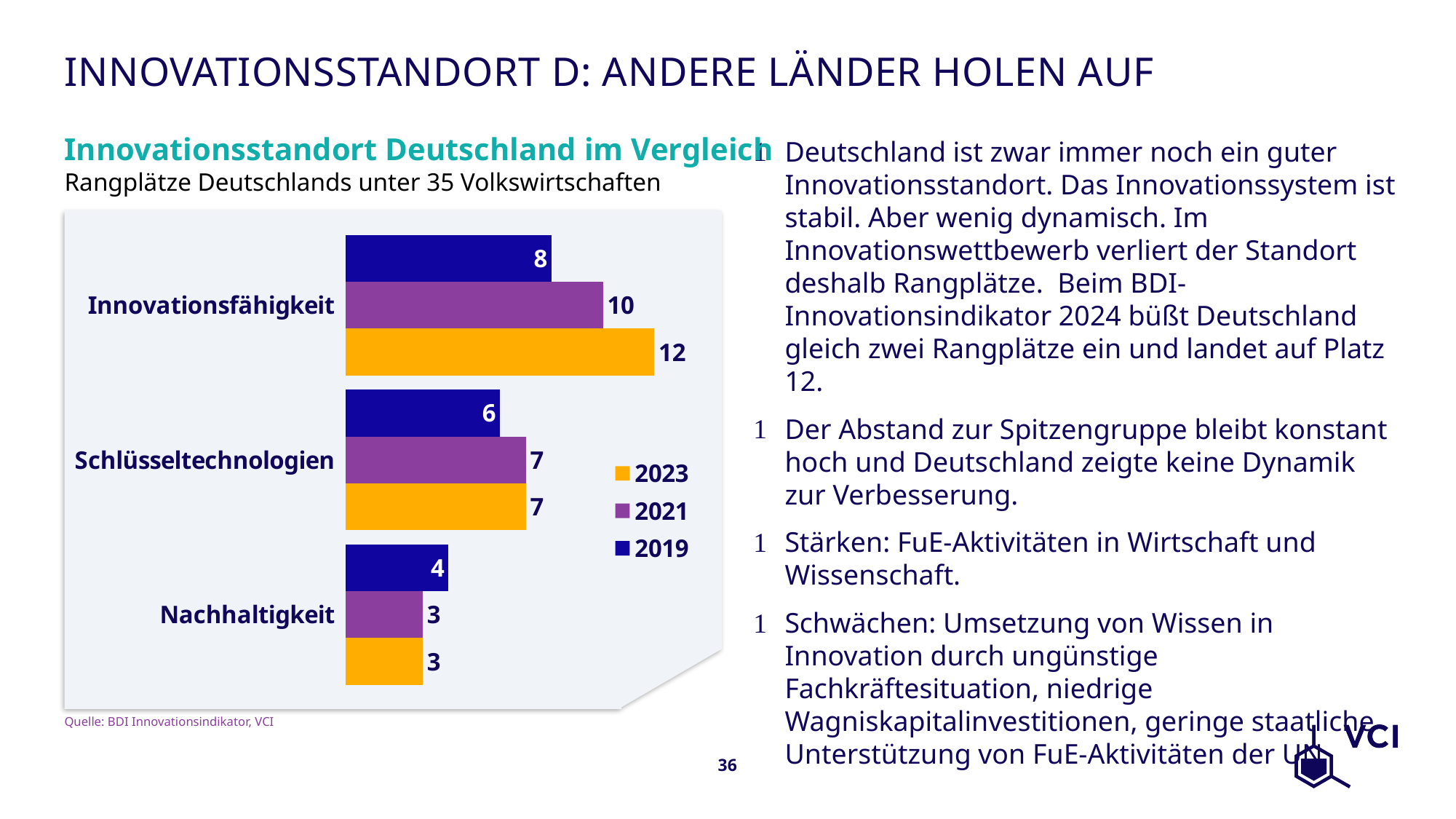
Which category has the lowest value in 2019? Nachhaltigkeit Which category has the highest value in 2023? Innovationsfähigkeit Which year is shown in orange in the legend? 2023 What is Germany's rank for Innovationsfähigkeit in 2023? 12 What is the difference between the 2023 and 2019 values for Innovationsfähigkeit? 4 How many series does the legend list? 3 What is the subtitle of the chart? Rangplätze Deutschlands unter 35 Volkswirtschaften What is Germany's rank for Schlüsseltechnologien in 2019? 6 What kind of chart is shown on the slide? Bar chart How many categories are shown on the chart? 3 Which is larger for Nachhaltigkeit, the 2019 value or the 2023 value? 2019 What is Germany's rank for Nachhaltigkeit in 2021? 3